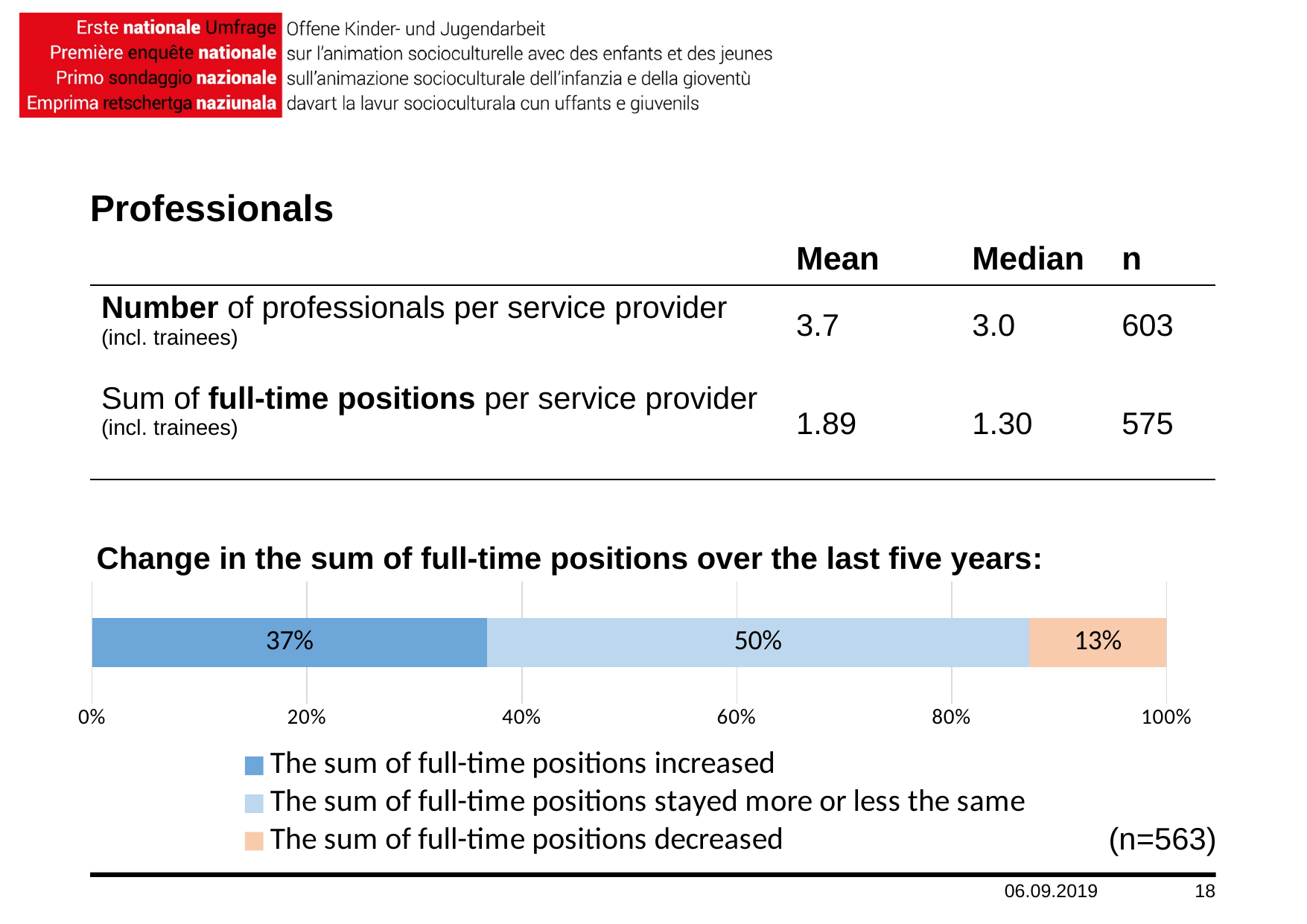
Which response category has the smallest share in the chart? The sum of full-time positions decreased Is the share for 'The sum of full-time positions increased' greater or less than 40%? less What is the difference in percentage points between the 'stayed more or less the same' share and the 'increased' share? 13 percentage points What percentage of respondents reported that the sum of full-time positions decreased? 13% What percentage of respondents reported that the sum of full-time positions stayed more or less the same? 50% What percentage of respondents reported that the sum of full-time positions increased? 37% What kind of chart is shown on the slide? Stacked bar chart What is the sample size (n) given for the chart? 563 Which response category has the largest share in the chart? The sum of full-time positions stayed more or less the same What is the difference in percentage points between the 'increased' share and the 'decreased' share? 24 percentage points How many series does the legend list? 3 Which is larger: the share that increased or the share that decreased? The share that increased